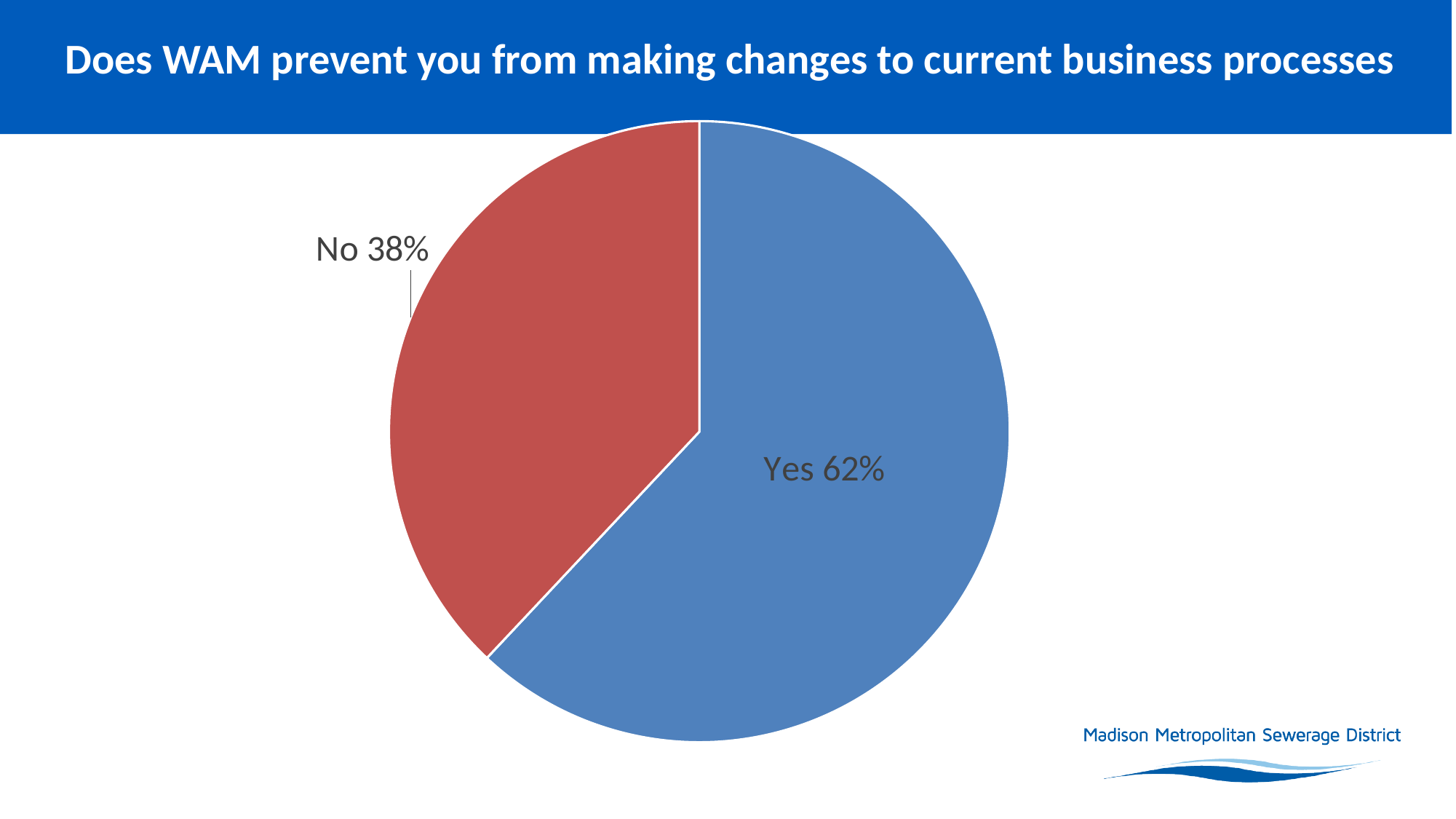
What is the title of the chart on the slide? Does WAM prevent you from making changes to current business processes Which response has the largest share of the pie? Yes Which is larger, the Yes share or the No share? Yes What percentage of respondents answered Yes? 62% What colour is the Yes slice of the pie? blue What is the difference in percentage points between the Yes and No shares? 24 What share of the pie does the No slice represent? 38% Which response has the smallest share of the pie? No What percentage of respondents answered No? 38% How many slices does the pie chart have? 2 What kind of chart is shown on the slide? pie chart